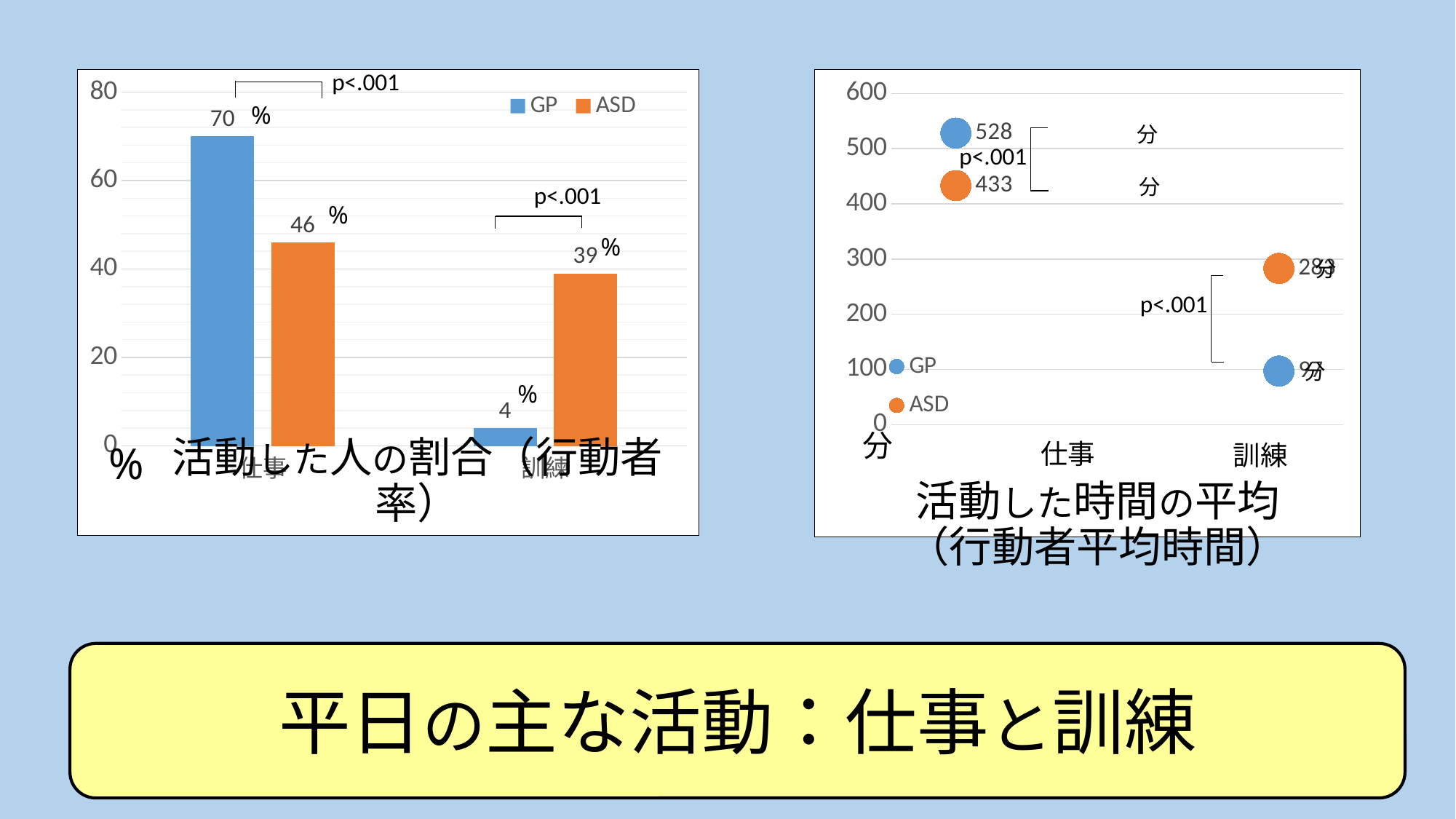
In the left chart (活動した人の割合), which series has the larger value for 訓練, GP or ASD? ASD In the right chart (活動した時間の平均), is the value for ASD in the 訓練 category greater or less than 200? greater In the left chart (活動した人の割合), what is the value for GP in the 仕事 category? 70% In the left chart (活動した人の割合), what is the difference between the GP and ASD values for 仕事? 24% What kind of chart is the left chart (活動した人の割合)? Bar chart How many series does the legend of the left chart (活動した人の割合) list? 2 In the left chart (活動した人の割合), what is the value for ASD in the 仕事 category? 46% In the right chart (活動した時間の平均), what is the value for GP in the 仕事 category? 528分 In the left chart (活動した人の割合), what is the value for ASD in the 訓練 category? 39% In the left chart (活動した人の割合), which bar is the lowest? GP, 訓練 In the left chart (活動した人の割合), what is the value for GP in the 訓練 category? 4% In the right chart (活動した時間の平均), what is the value for ASD in the 仕事 category? 433分